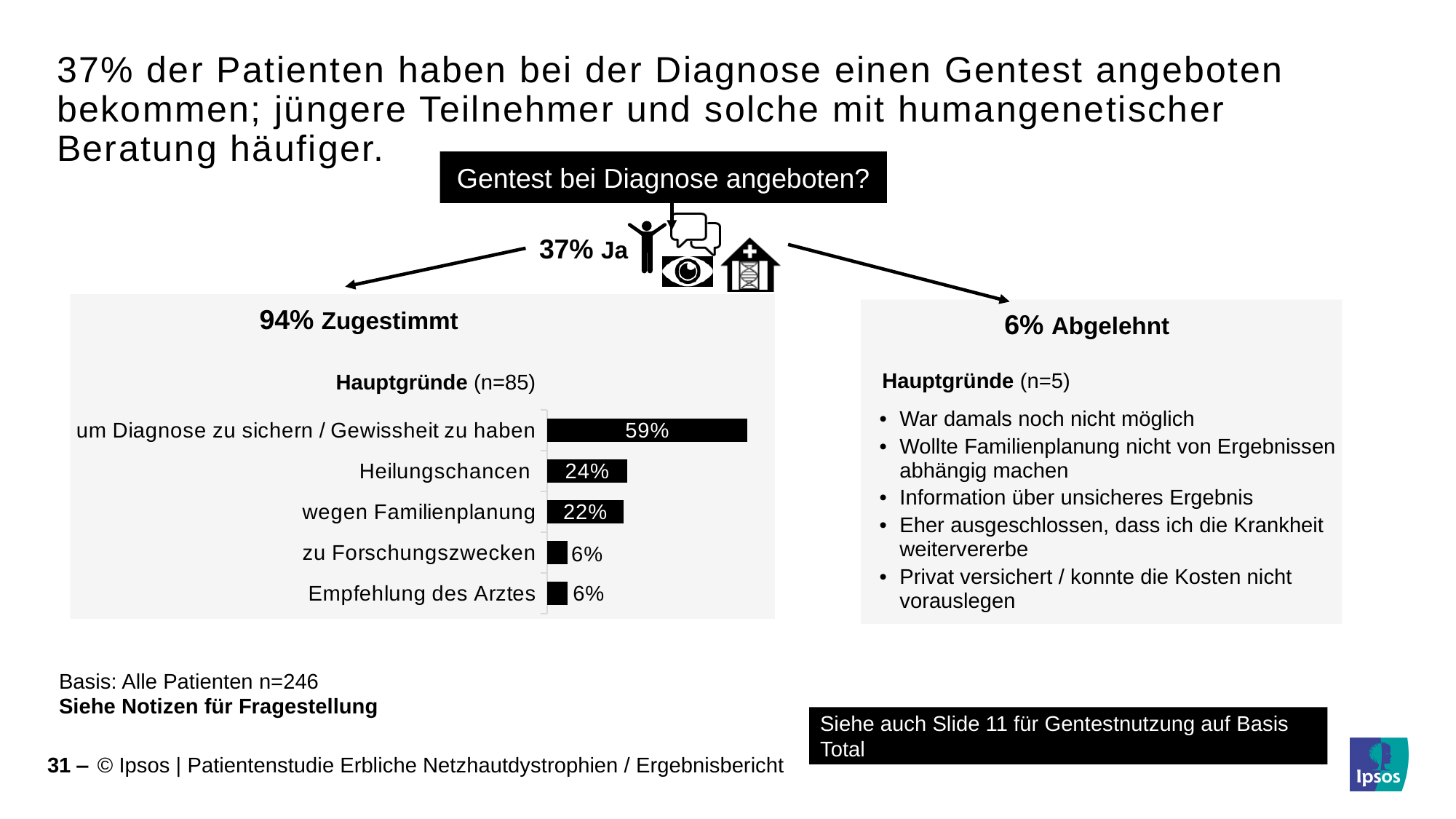
What value is shown for "wegen Familienplanung" in the Hauptgründe bar chart? 22% In the Hauptgründe bar chart, which is larger: the value for "Heilungschancen" or for "wegen Familienplanung"? Heilungschancen What is the sample size (n) given for the Hauptgründe bar chart? n=85 What colour are the bars in the Hauptgründe bar chart? Black What is the difference between the values for "Heilungschancen" and "wegen Familienplanung" in the Hauptgründe bar chart? 2% What kind of chart is the Hauptgründe chart? Bar chart What value is shown for "zu Forschungszwecken" in the Hauptgründe bar chart? 6% What is the difference between the values for "um Diagnose zu sichern / Gewissheit zu haben" and "Heilungschancen" in the Hauptgründe bar chart? 35% How many categories are shown in the Hauptgründe bar chart? 5 What value is shown for "um Diagnose zu sichern / Gewissheit zu haben" in the Hauptgründe bar chart? 59% What value is shown for "Heilungschancen" in the Hauptgründe bar chart? 24% Which category has the highest value in the Hauptgründe bar chart? um Diagnose zu sichern / Gewissheit zu haben